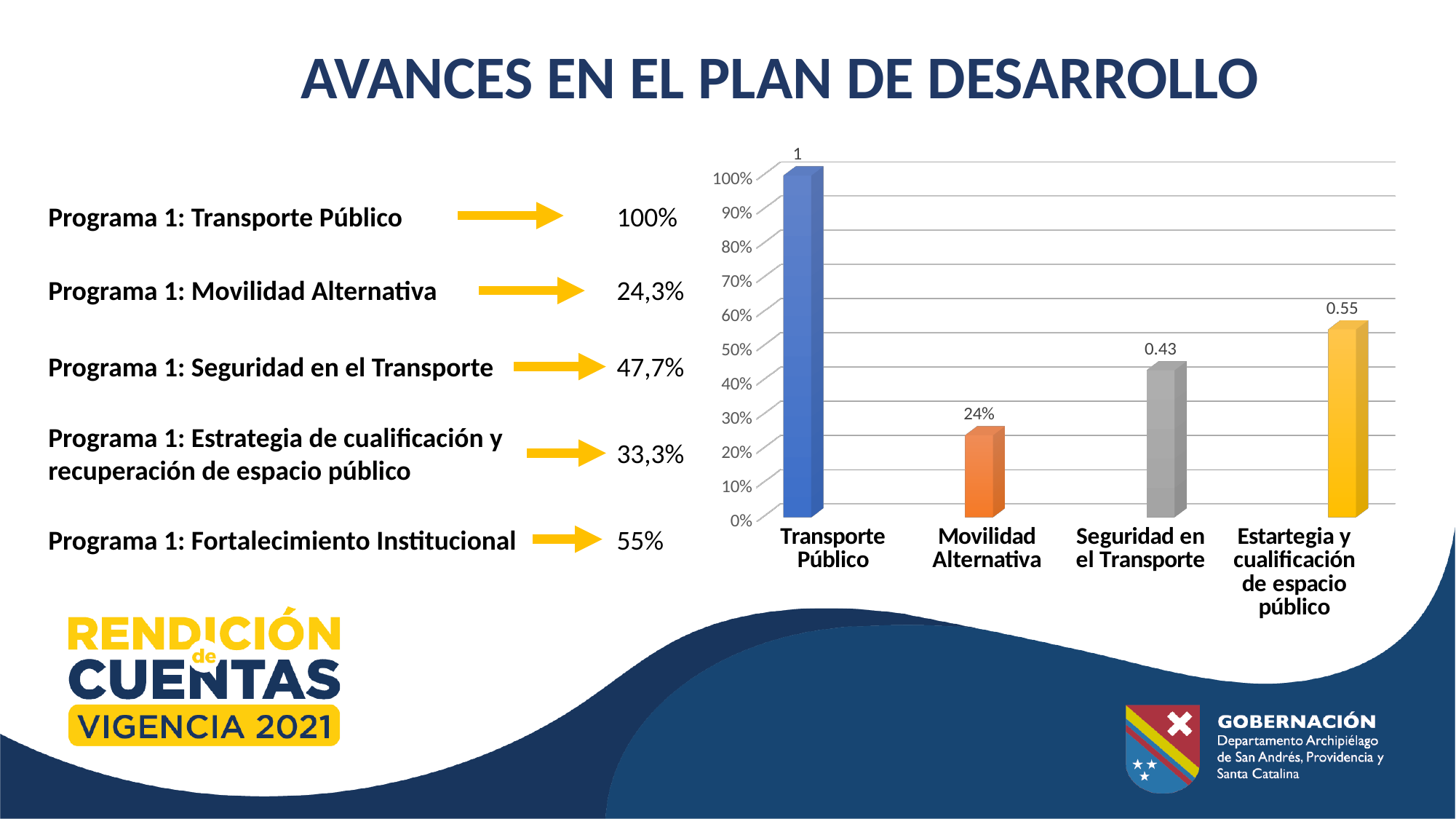
What colour is the bar for Movilidad Alternativa? orange What is the data label shown on the bar for Estartegia y cualificación de espacio público? 0.55 What is the data label shown on the bar for Movilidad Alternativa? 24% What is the data label shown on the bar for Transporte Público? 1 What is the data label shown on the bar for Seguridad en el Transporte? 0.43 What kind of chart is shown on the slide? bar chart Is the value for Seguridad en el Transporte greater or less than 50%? less Is the value for Estartegia y cualificación de espacio público greater or less than 50%? greater Which category has the highest bar in the chart? Transporte Público How many categories are plotted in the chart? 4 Which category has the lowest bar in the chart? Movilidad Alternativa Which bar is taller: Seguridad en el Transporte or Estartegia y cualificación de espacio público? Estartegia y cualificación de espacio público